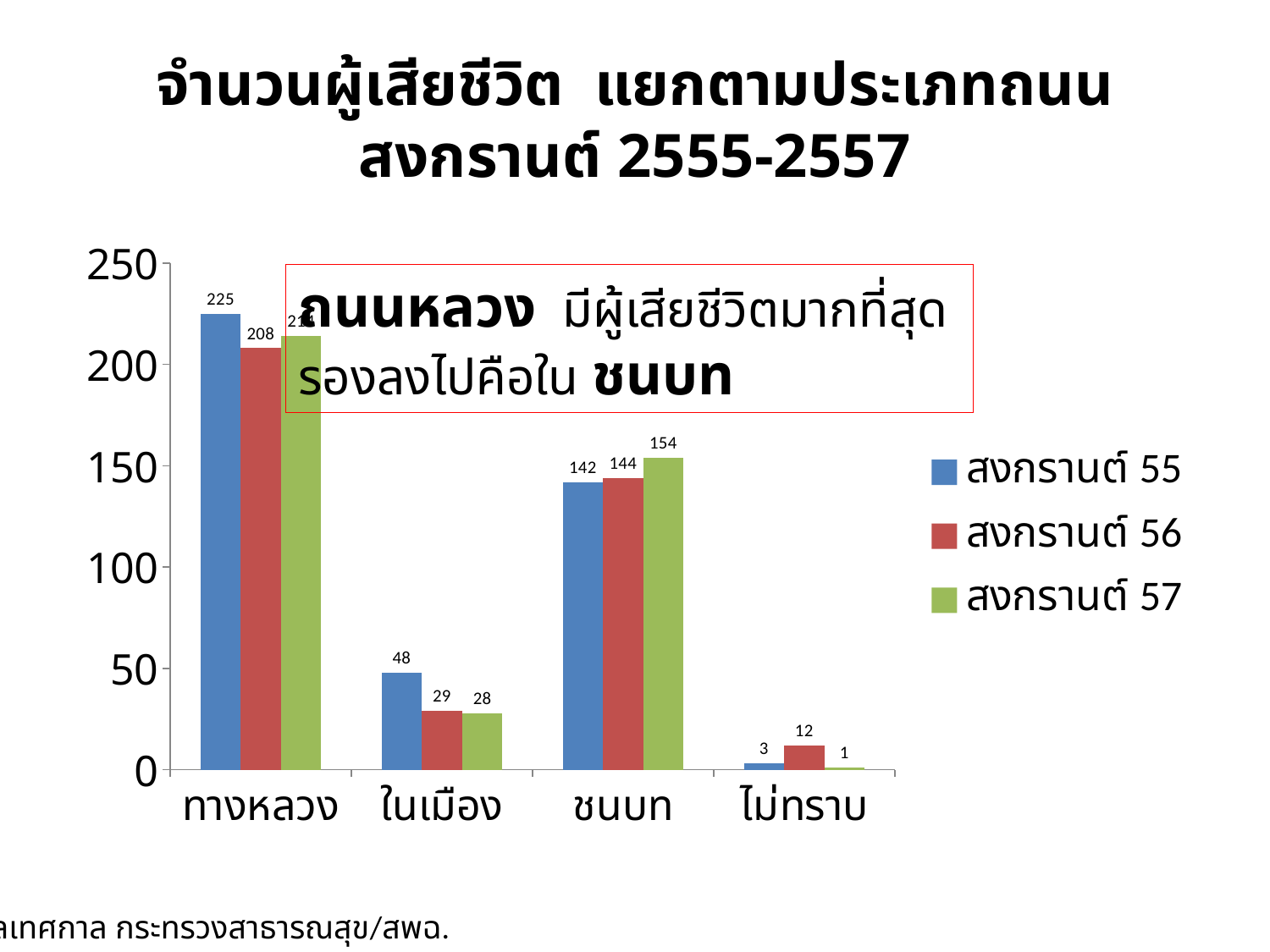
What is the value for ในเมือง in the สงกรานต์ 55 series? 48 What is the value for ไม่ทราบ in the สงกรานต์ 56 series? 12 How many series does the legend list? 3 What type of chart is shown on the slide? bar chart Which is larger for ชนบท: the สงกรานต์ 55 value or the สงกรานต์ 57 value? สงกรานต์ 57 Which category has the highest value in the สงกรานต์ 55 series? ทางหลวง What is the value for ทางหลวง in the สงกรานต์ 55 series? 225 What is the difference between the สงกรานต์ 55 and สงกรานต์ 56 values for ในเมือง? 19 What is the value for ทางหลวง in the สงกรานต์ 56 series? 208 What is the value for ชนบท in the สงกรานต์ 57 series? 154 Which category has the lowest value in the สงกรานต์ 57 series? ไม่ทราบ How many road-type categories are shown on the x axis? 4